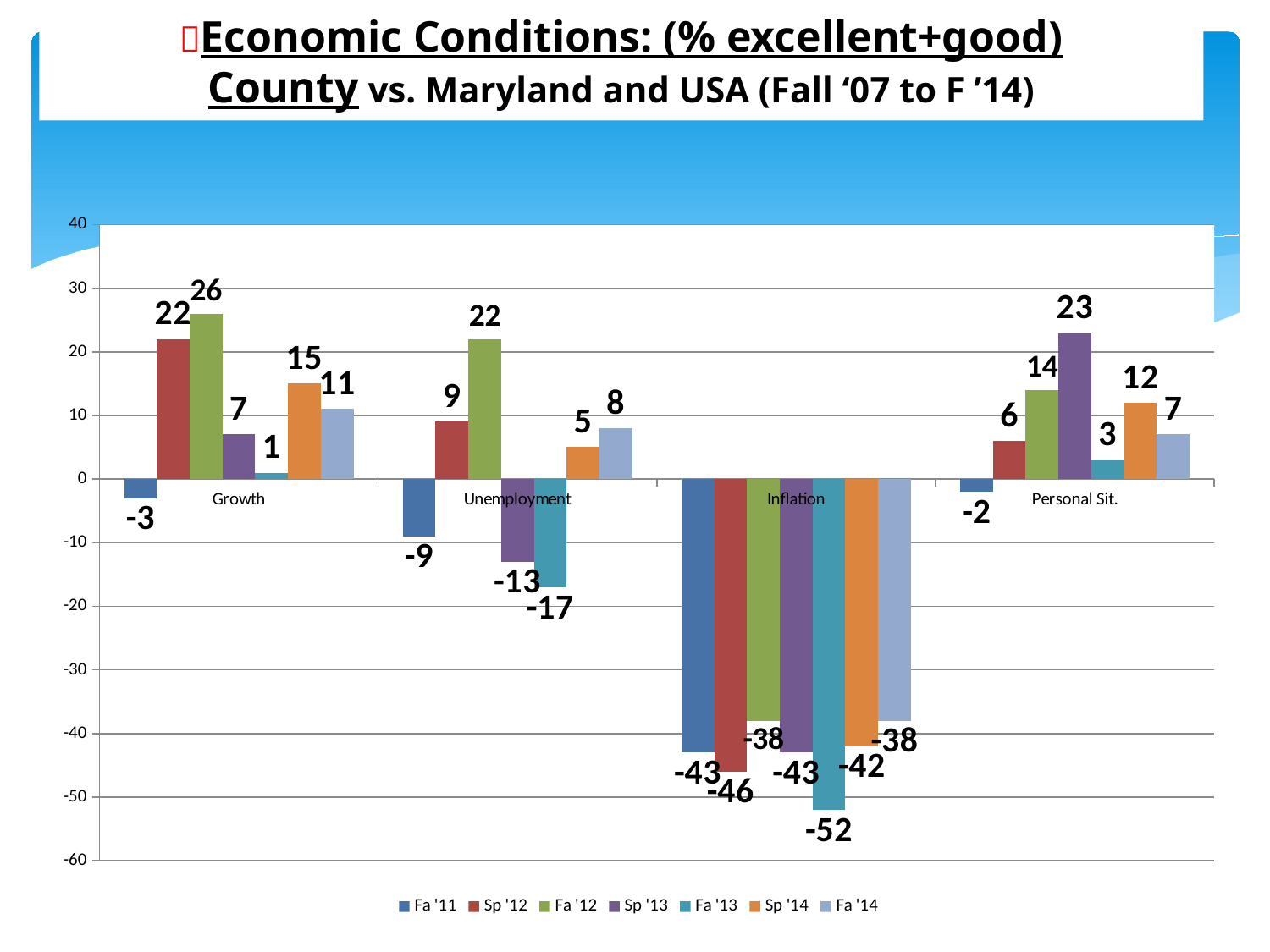
Which category has all of its values below zero? Inflation What is the value for Fa '12 in the Growth category? 26 Which series has the lowest value in the Inflation category? Fa '13 What is the difference between the Sp '14 and Fa '14 values in the Growth category? 4 Which is larger in the Personal Sit. category: the Fa '12 value or the Sp '14 value? Fa '12 What is the value for Sp '13 in the Personal Sit. category? 23 What kind of chart is shown on the slide? Bar chart What is the value for Fa '11 in the Unemployment category? -9 What is the value for Fa '13 in the Inflation category? -52 Which series has the highest value in the Unemployment category? Fa '12 How many categories are shown on the x axis? 4 How many series does the legend list? 7